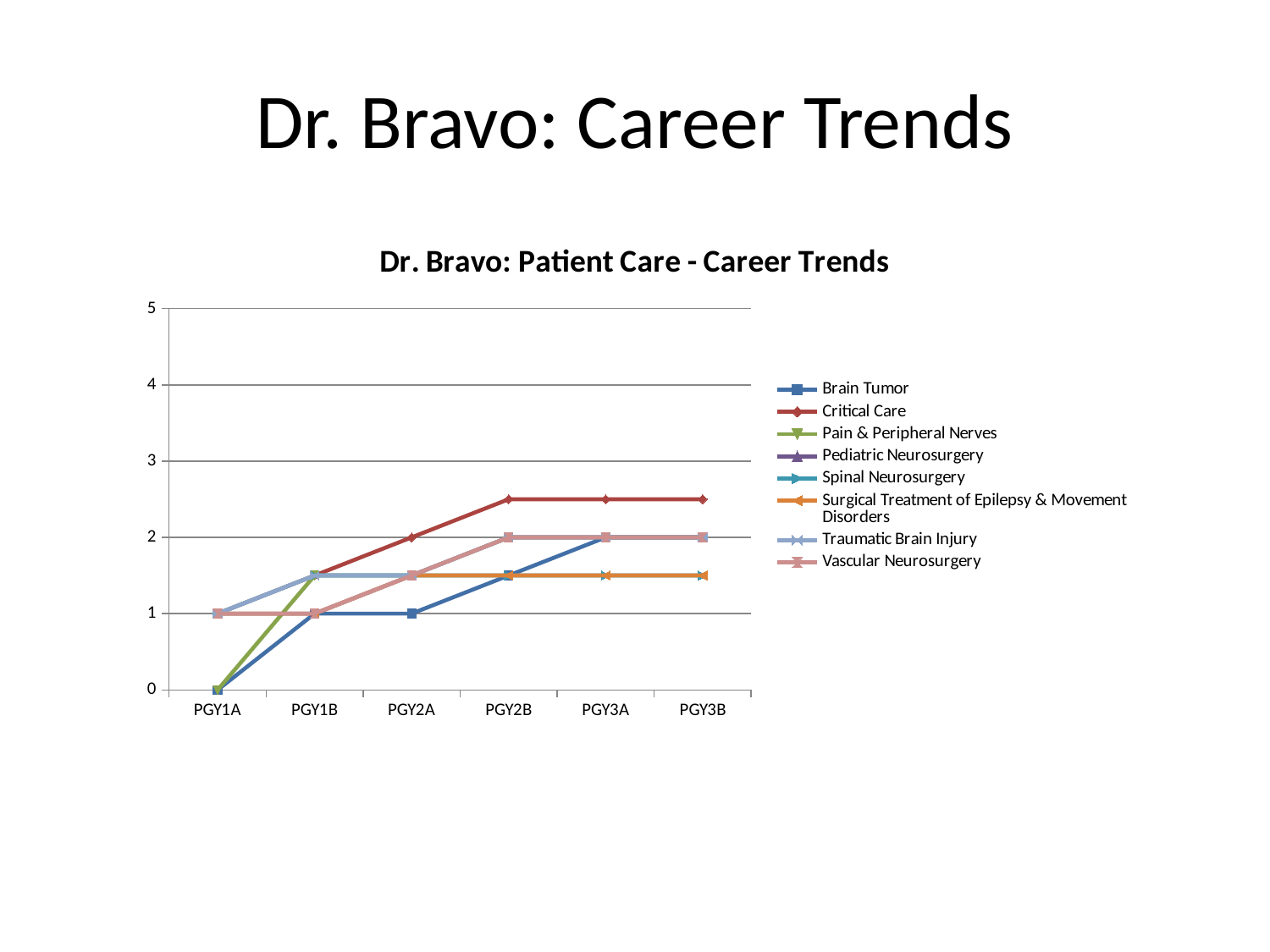
How many categories are shown on the x axis? 6 Does the Critical Care series rise or fall from PGY1A to PGY3B? rise At PGY3A, which is larger: Critical Care or Brain Tumor? Critical Care Is the value for Brain Tumor at PGY2B greater or less than 2? less What kind of chart is shown on the slide? line chart Which series has the highest value at PGY3B? Critical Care How many series does the legend list? 8 Is the value for Critical Care at PGY3B greater or less than 2? greater What is the value for Brain Tumor at PGY1A? 0 What is the value for Critical Care at PGY2A? 2 What is the difference between Critical Care and Brain Tumor at PGY2A? 1 What is the value for Brain Tumor at PGY3B? 2